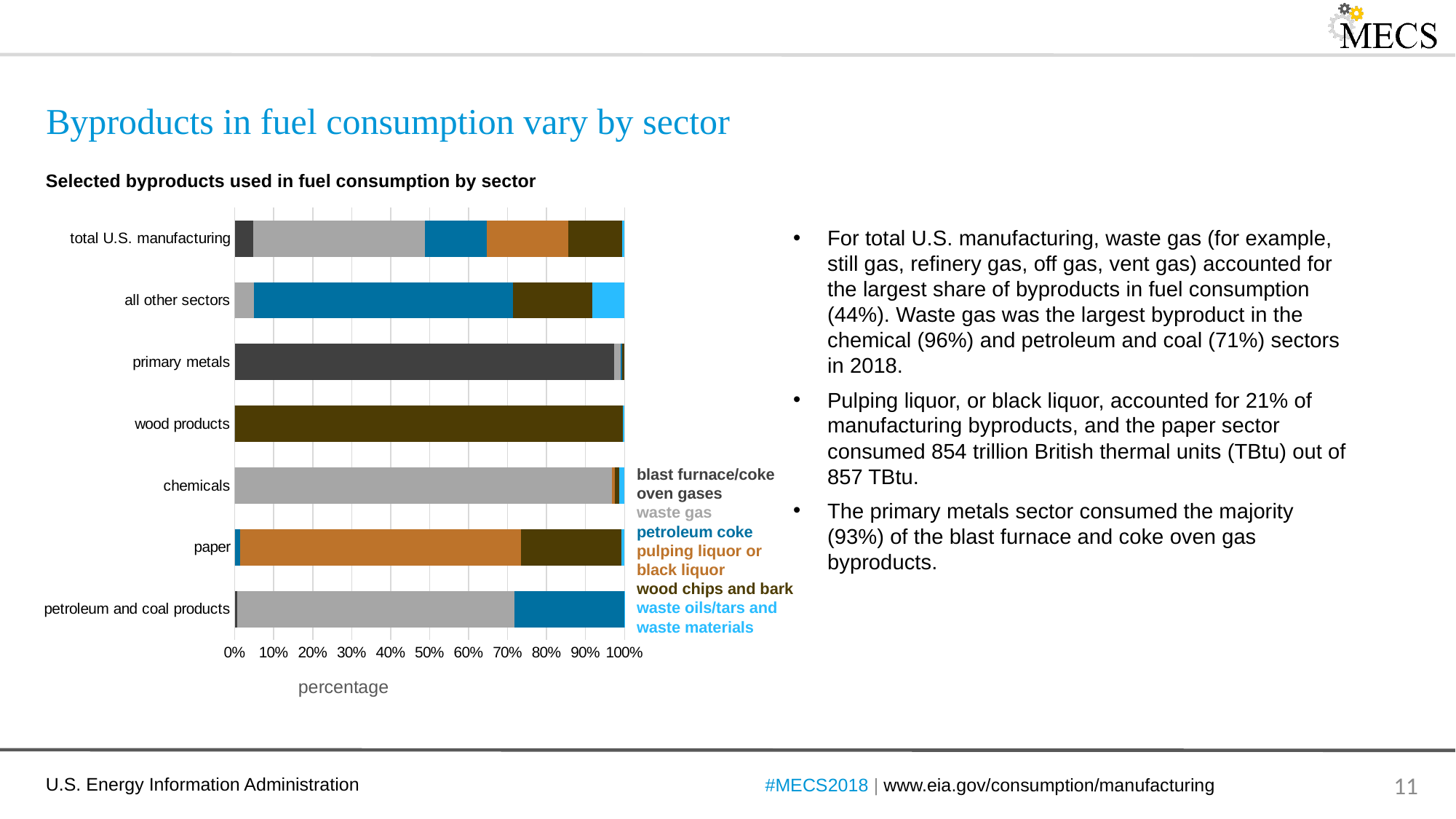
How many byproduct series does the chart's legend list? 6 How many sectors (categories) are plotted on the y axis of the chart? 7 What kind of chart is shown on the slide? stacked bar chart Which sector has the largest share of blast furnace/coke oven gases in its bar? primary metals Is the waste gas share for total U.S. manufacturing greater or less than 50%? less Which sector has the largest share of wood chips and bark in its bar? wood products Is the waste gas share for chemicals greater or less than 90%? greater Is the pulping liquor or black liquor share for paper greater or less than 60%? greater Which sector has the largest share of waste gas in its bar? chemicals What is the title of the chart? Selected byproducts used in fuel consumption by sector What is the label on the x axis of the chart? percentage For total U.S. manufacturing, which is larger: the waste gas share or the petroleum coke share? waste gas